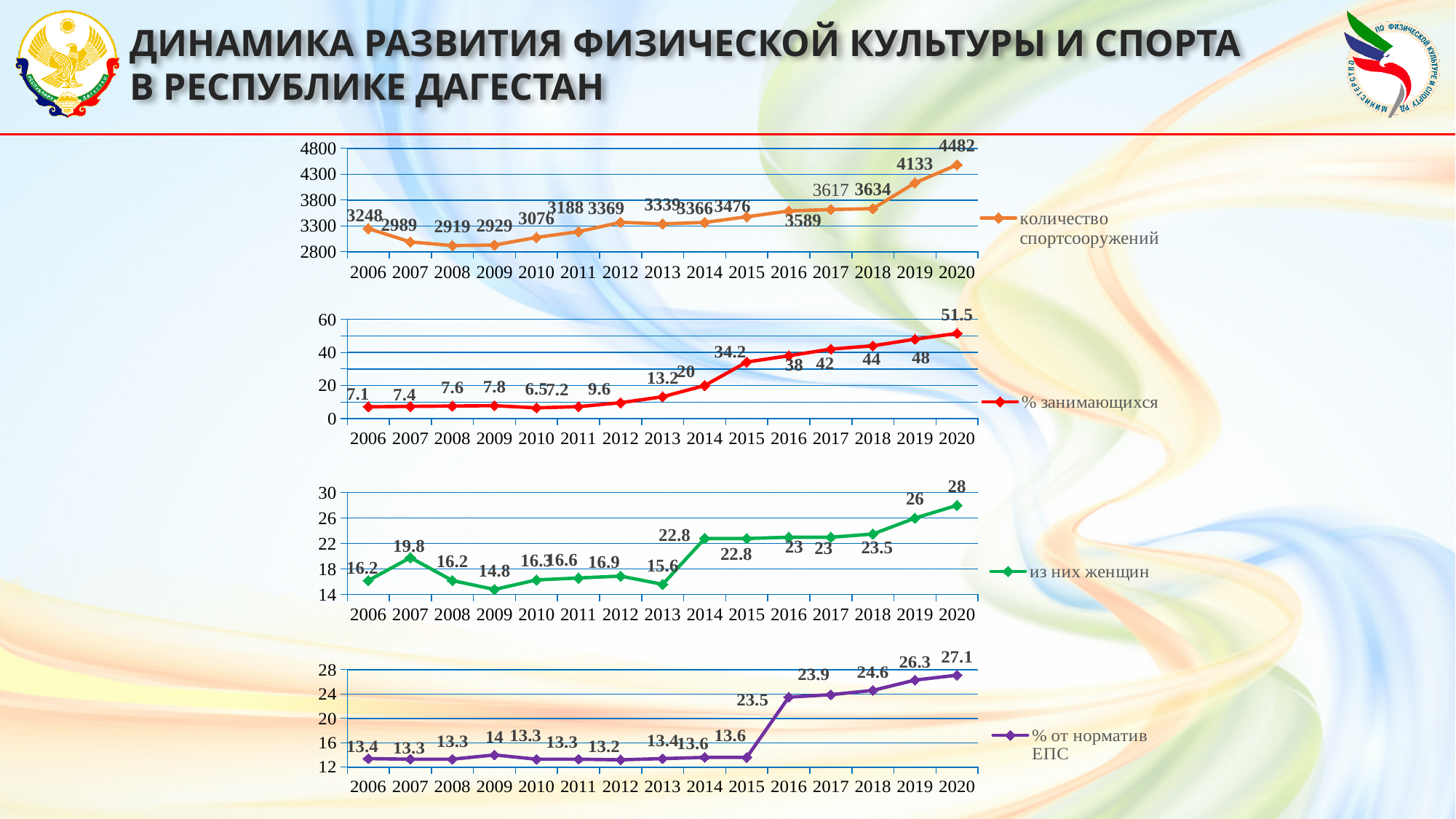
In the third chart (из них женщин), which is larger, the value for 2009 or the value for 2013? 2013 In the second chart (% занимающихся), what is the value for 2015? 34.2 In the second chart (% занимающихся), which year has the highest value? 2020 In the bottom chart (% от норматив ЕПС), what is the value for 2016? 23.5 In the bottom chart (% от норматив ЕПС), what is the difference between the 2020 and 2006 values? 13.7 In the top chart (количество спортсооружений), which year has the lowest value? 2008 In the second chart (% занимающихся), which year has the lowest value? 2010 What kind of chart is the top chart (количество спортсооружений)? Line chart In the third chart (из них женщин), what is the value for 2007? 19.8 In the top chart (количество спортсооружений), what is the value for 2020? 4482 In the top chart (количество спортсооружений), what is the difference between the 2020 and 2019 values? 349 How many years are plotted on the x axis of the bottom chart (% от норматив ЕПС)? 15